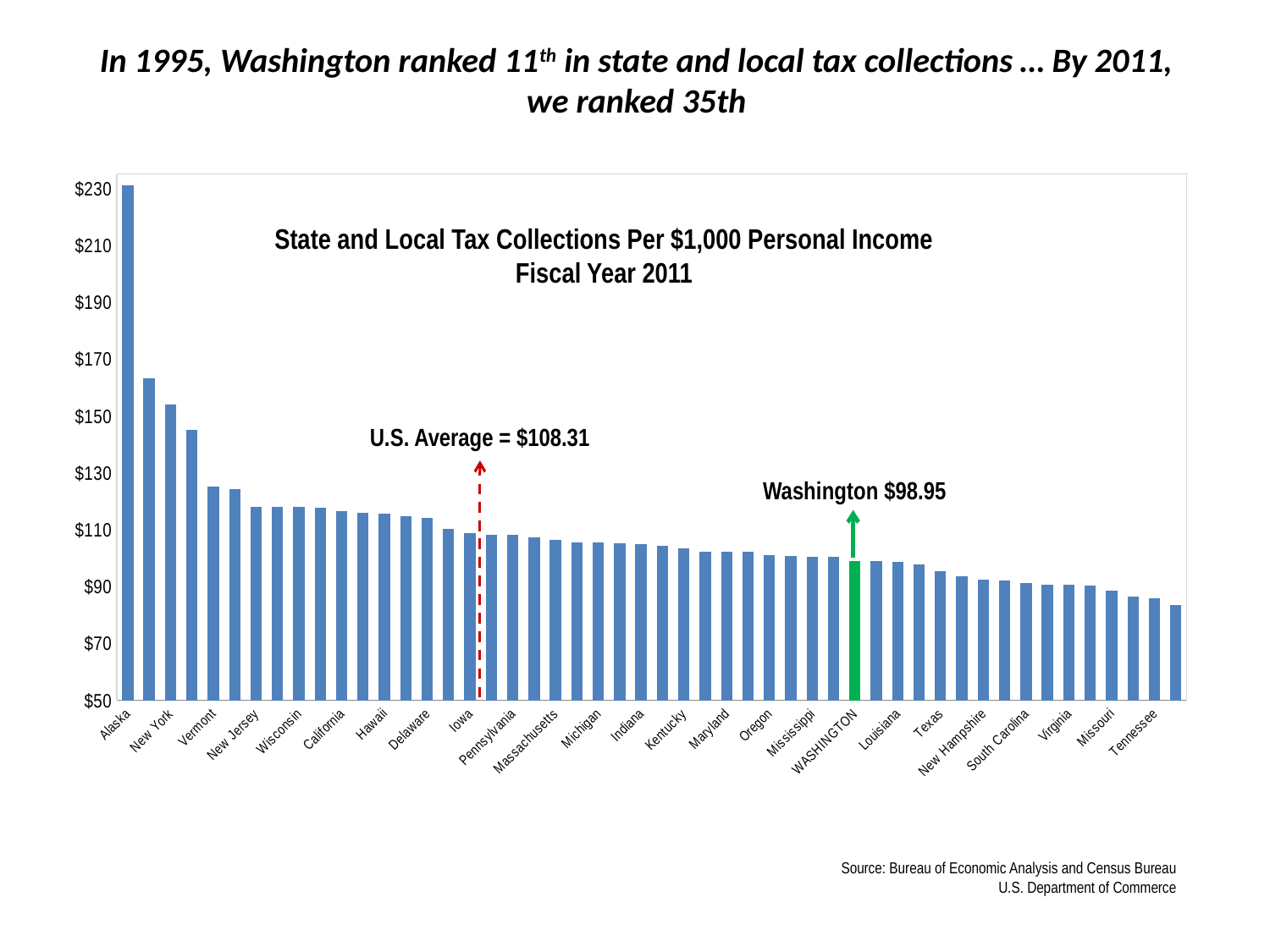
How much lower is Washington's value than the U.S. average? $9.36 Is the value for New York greater or less than $150? greater Is the value for Vermont greater or less than $130? less Is the value for Alaska greater or less than $210? greater What is the U.S. average value marked on the chart? $108.31 What colour is the bar for Washington? green Do the bar values rise or fall from left to right across the chart? fall Which state has the highest bar in the chart? Alaska What kind of chart is shown on the slide? bar chart Which is larger, the value for Washington or the U.S. average? U.S. average What is the value shown for Washington in the chart? $98.95